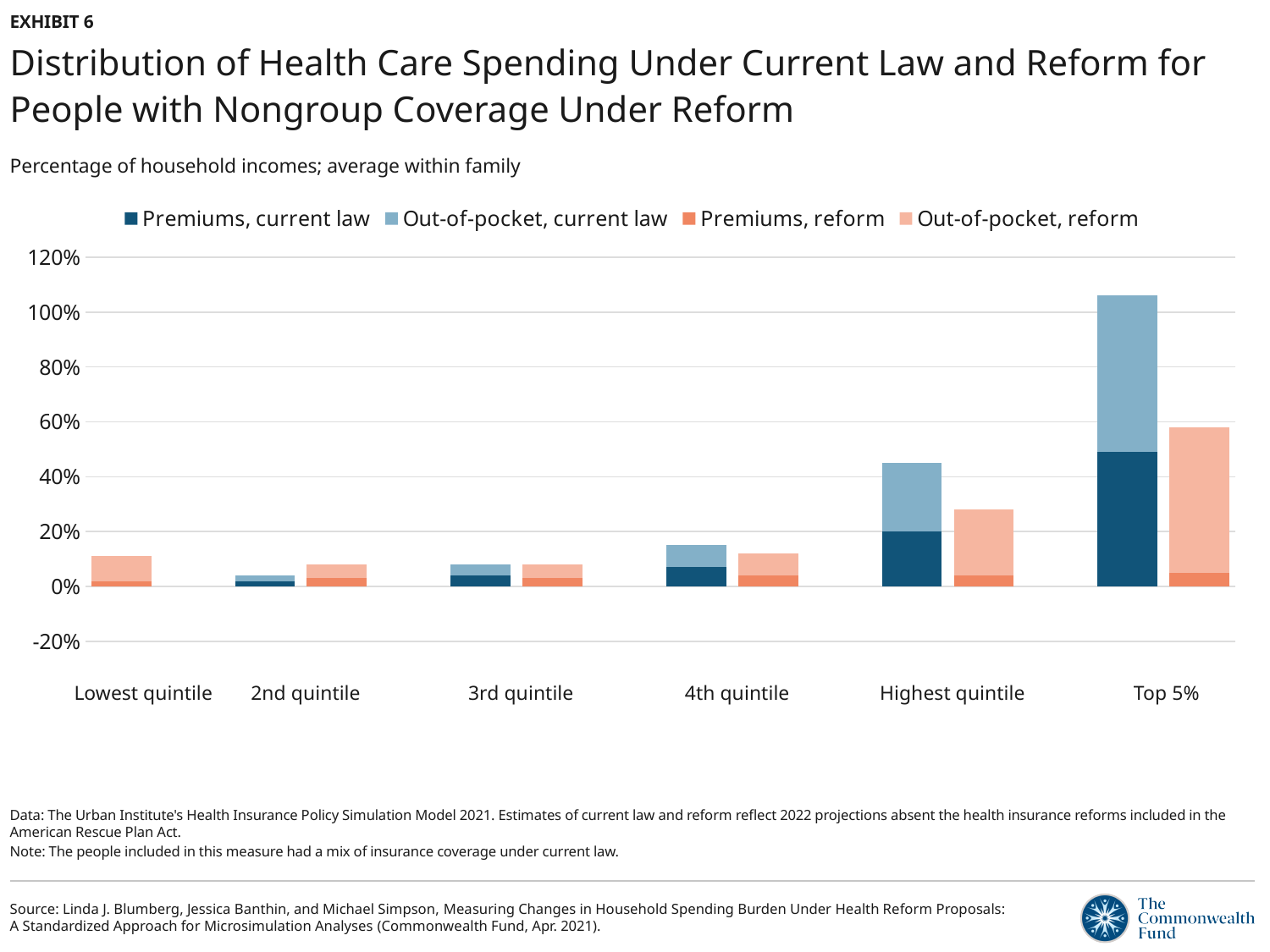
For the Lowest quintile, which stacked bar is taller: current law or reform? reform Is the total of the current-law stacked bar for Top 5% greater or less than 100%? greater For the Highest quintile, which stacked bar is taller: current law or reform? current law Which category has the tallest current-law stacked bar? Top 5% How many series does the legend list? 4 What colour represents Premiums, current law in the chart? dark blue What unit does the chart's subtitle say the values are measured in? Percentage of household incomes; average within family Is the total of the reform stacked bar for Top 5% greater or less than 40%? greater Is the total of the current-law stacked bar for the Highest quintile greater or less than 60%? less How many income categories are shown on the x axis? 6 What kind of chart is shown on the slide? bar chart